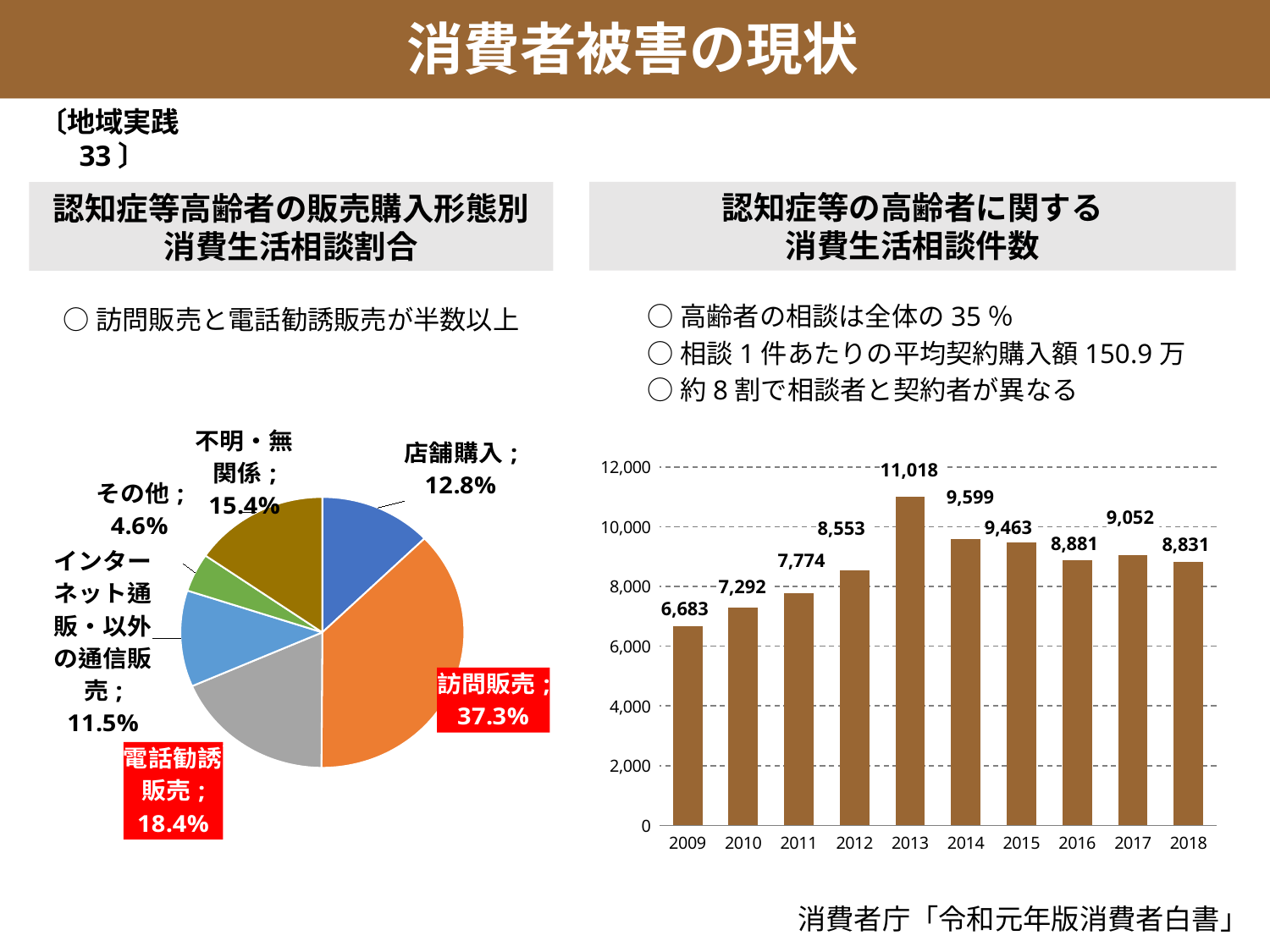
左の円グラフで、最も割合が大きい販売購入形態はどれですか？ 訪問販売 左の円グラフ「認知症等高齢者の販売購入形態別消費生活相談割合」で、訪問販売の割合は何%ですか？ 37.3% 右の棒グラフで、2013年と2009年の相談件数の差はいくつですか？ 4,335 右の棒グラフで、相談件数が最も少ない年はいつですか？ 2009 左の円グラフには、いくつの区分がありますか？ 6 右のグラフ「認知症等の高齢者に関する消費生活相談件数」はどの種類のグラフですか？ 棒グラフ 左の円グラフで、訪問販売と電話勧誘販売の割合の差は何ポイントですか？ 18.9ポイント 左の円グラフで、店舗購入と不明・無関係ではどちらの割合が大きいですか？ 不明・無関係 右の棒グラフで、2013年の相談件数はいくつですか？ 11,018 右の棒グラフで、2009年から2013年にかけて相談件数は増加していますか、減少していますか？ 増加 左の円グラフで、最も割合が小さい販売購入形態はどれですか？ その他 左の円グラフで、電話勧誘販売の割合は何%ですか？ 18.4%